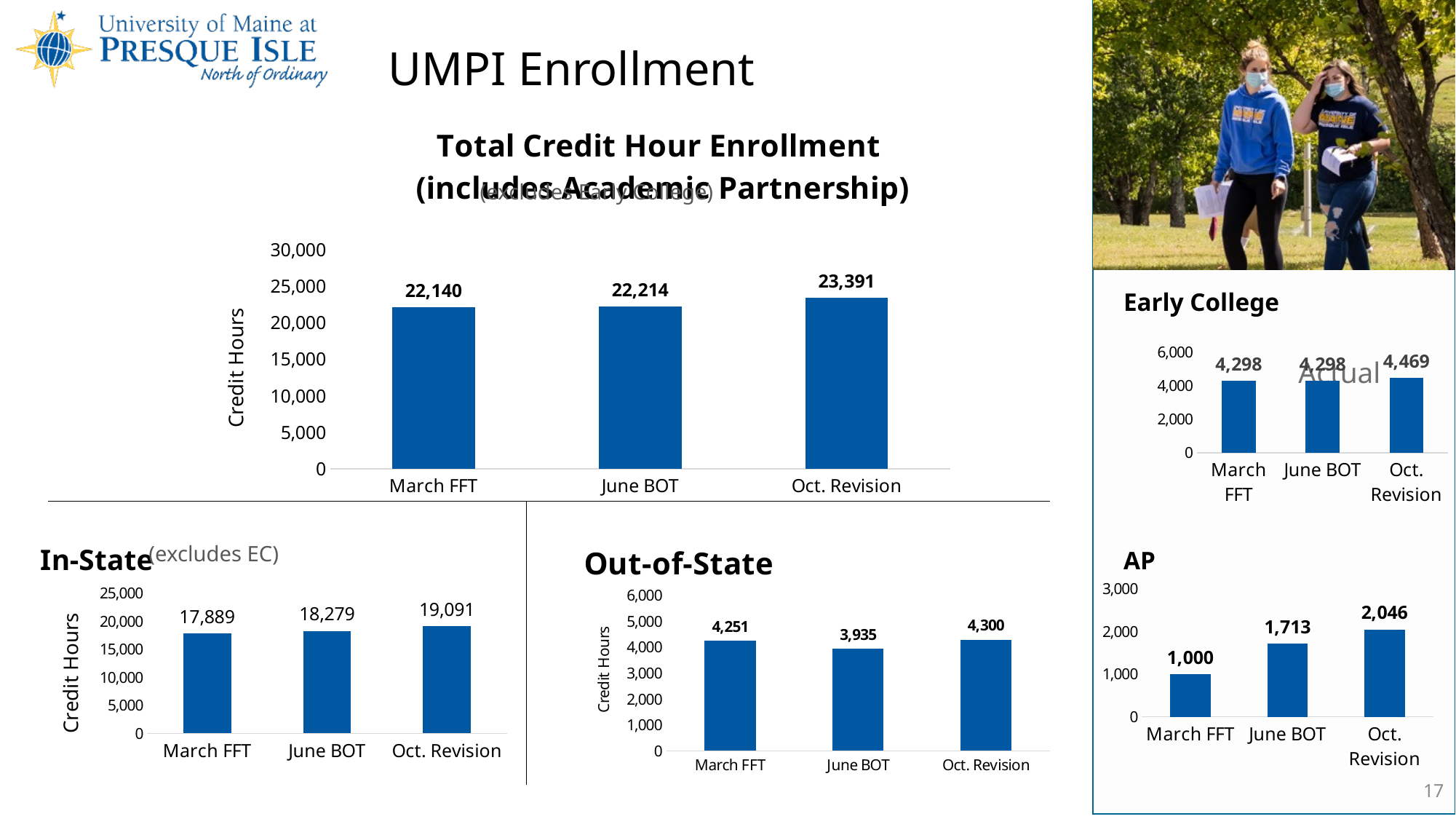
In the Early College chart, what is the value for Oct. Revision? 4,469 In the In-State chart, what is the value for June BOT? 18,279 In the Total Credit Hour Enrollment chart, what is the value for Oct. Revision? 23,391 How many categories are shown on the x axis of the Total Credit Hour Enrollment chart? 3 In the AP chart, do the values rise or fall from March FFT to Oct. Revision? rise In the Out-of-State chart, which category has the lowest value? June BOT In the Total Credit Hour Enrollment chart, what is the difference between the Oct. Revision and March FFT values? 1,251 What kind of chart is the Out-of-State chart? bar chart In the Out-of-State chart, what is the value for March FFT? 4,251 In the In-State chart, which category has the highest value? Oct. Revision In the AP chart, what is the value for March FFT? 1,000 In the AP chart, what is the difference between the Oct. Revision and June BOT values? 333